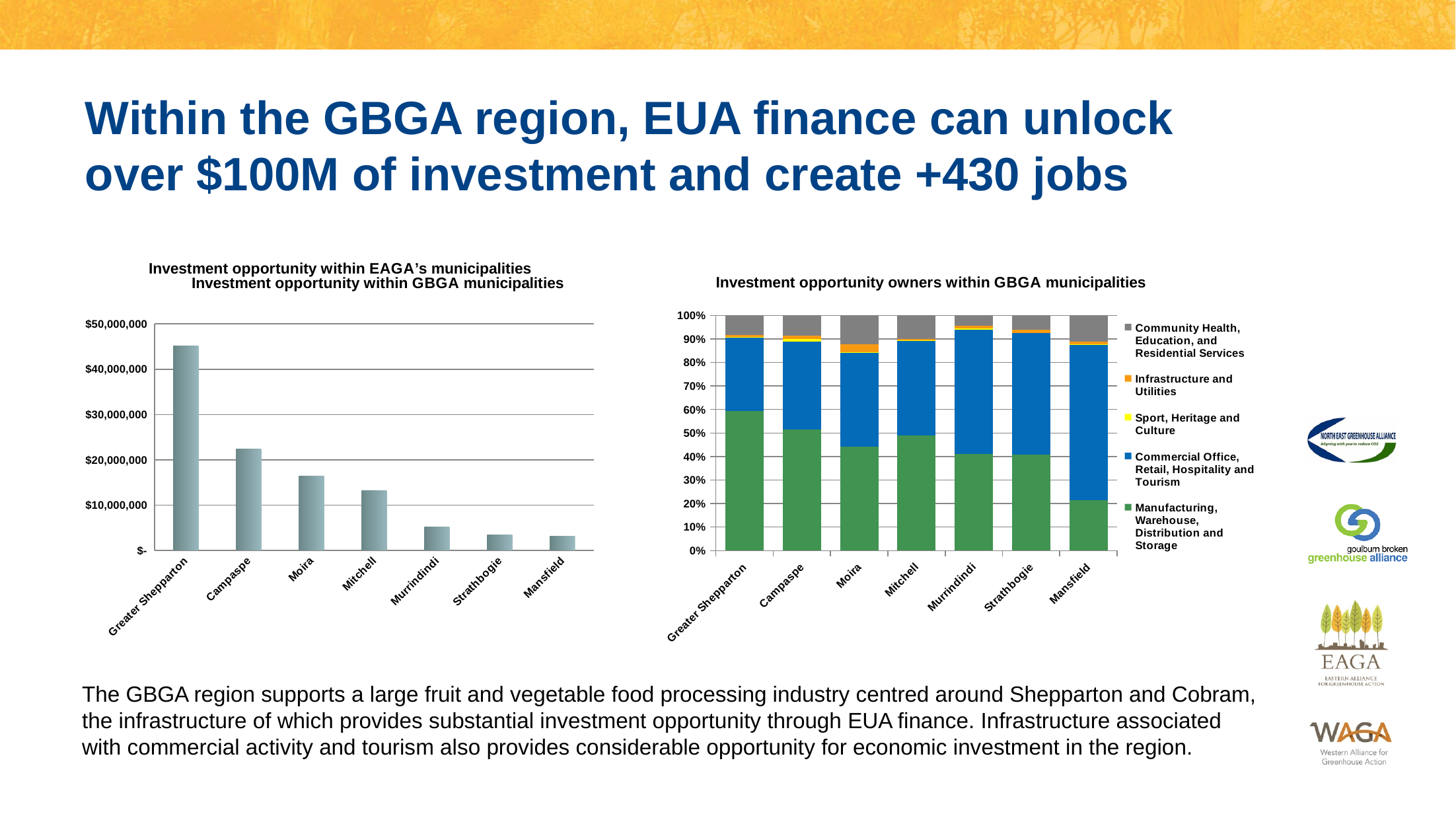
In the left chart, 'Investment opportunity within GBGA municipalities', is the value for Campaspe greater or less than $30,000,000? less In the right chart, 'Investment opportunity owners within GBGA municipalities', which municipality has the largest share for Manufacturing, Warehouse, Distribution and Storage? Greater Shepparton In the right chart, 'Investment opportunity owners within GBGA municipalities', which colour represents Commercial Office, Retail, Hospitality and Tourism? blue In the left chart, 'Investment opportunity within GBGA municipalities', which is larger, the value for Moira or the value for Mitchell? Moira How many series does the legend list in the right chart, 'Investment opportunity owners within GBGA municipalities'? 5 In the left chart, 'Investment opportunity within GBGA municipalities', do the values rise or fall moving from left to right along the x axis? fall What kind of chart is the 'Investment opportunity within GBGA municipalities' chart on the left? bar chart In the left chart, 'Investment opportunity within GBGA municipalities', how many municipalities are shown? 7 In the left chart, 'Investment opportunity within GBGA municipalities', which municipality has the highest investment opportunity? Greater Shepparton In the left chart, 'Investment opportunity within GBGA municipalities', is the value for Greater Shepparton greater or less than $40,000,000? greater In the left chart, 'Investment opportunity within GBGA municipalities', is the value for Murrindindi greater or less than $10,000,000? less In the right chart, 'Investment opportunity owners within GBGA municipalities', which municipality has the smallest share for Manufacturing, Warehouse, Distribution and Storage? Mansfield